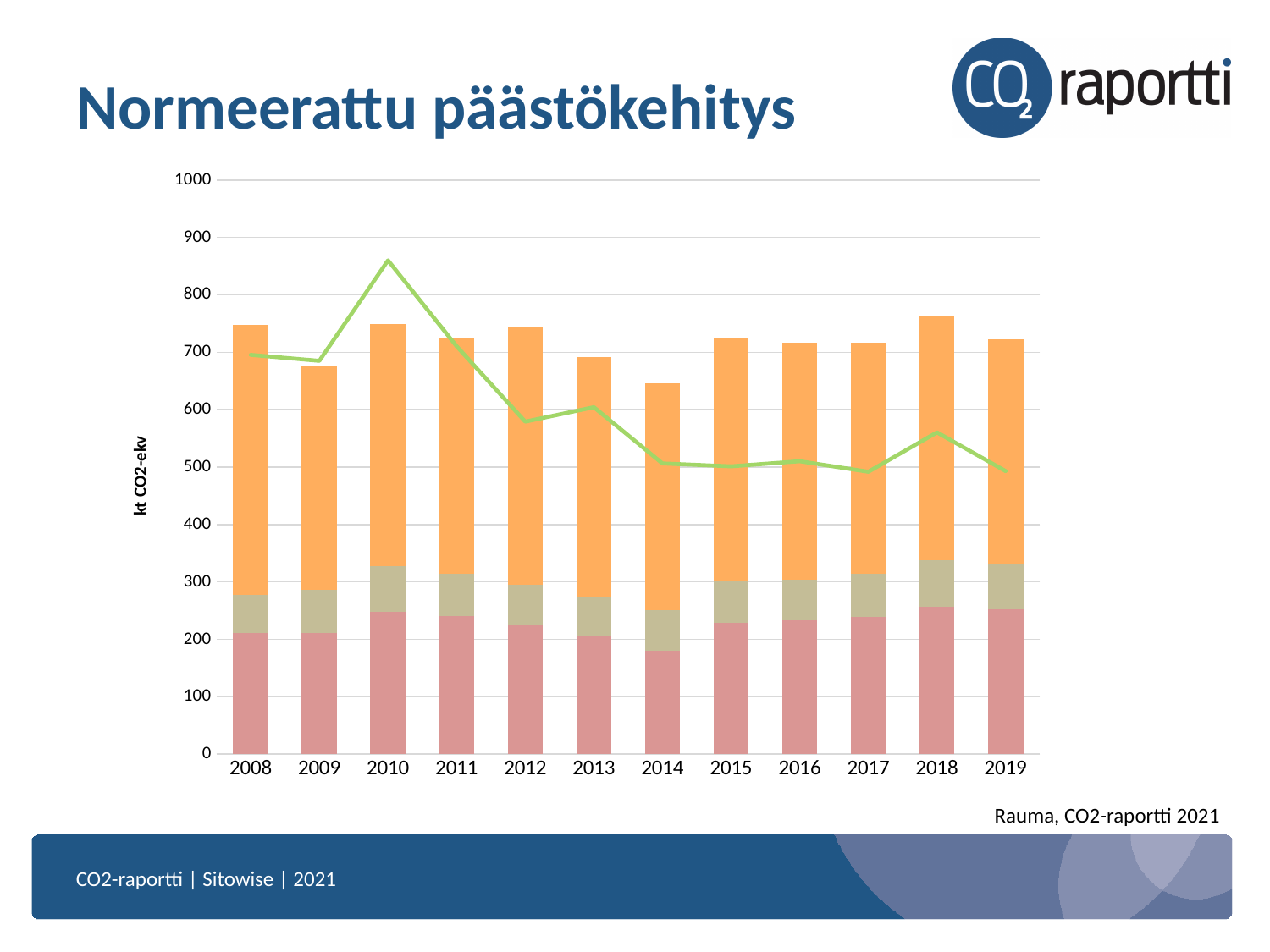
Is the value of the green line in 2019 greater or less than 600? less How many years are shown on the x axis of the chart? 12 What is the label on the vertical axis of the chart? kt CO2-ekv In which year is the total height of the stacked bar the lowest? 2014 Is the total height of the stacked bar for 2014 greater or less than 700? less Which year has the taller stacked bar, 2014 or 2015? 2015 What kind of chart is shown on the slide? A stacked bar chart with a line In which year does the green line reach its highest value? 2010 What is the title of the slide containing the chart? Normeerattu päästökehitys Is the value of the green line in 2010 greater or less than 800? greater Does the green line rise or fall between 2010 and 2014? Fall